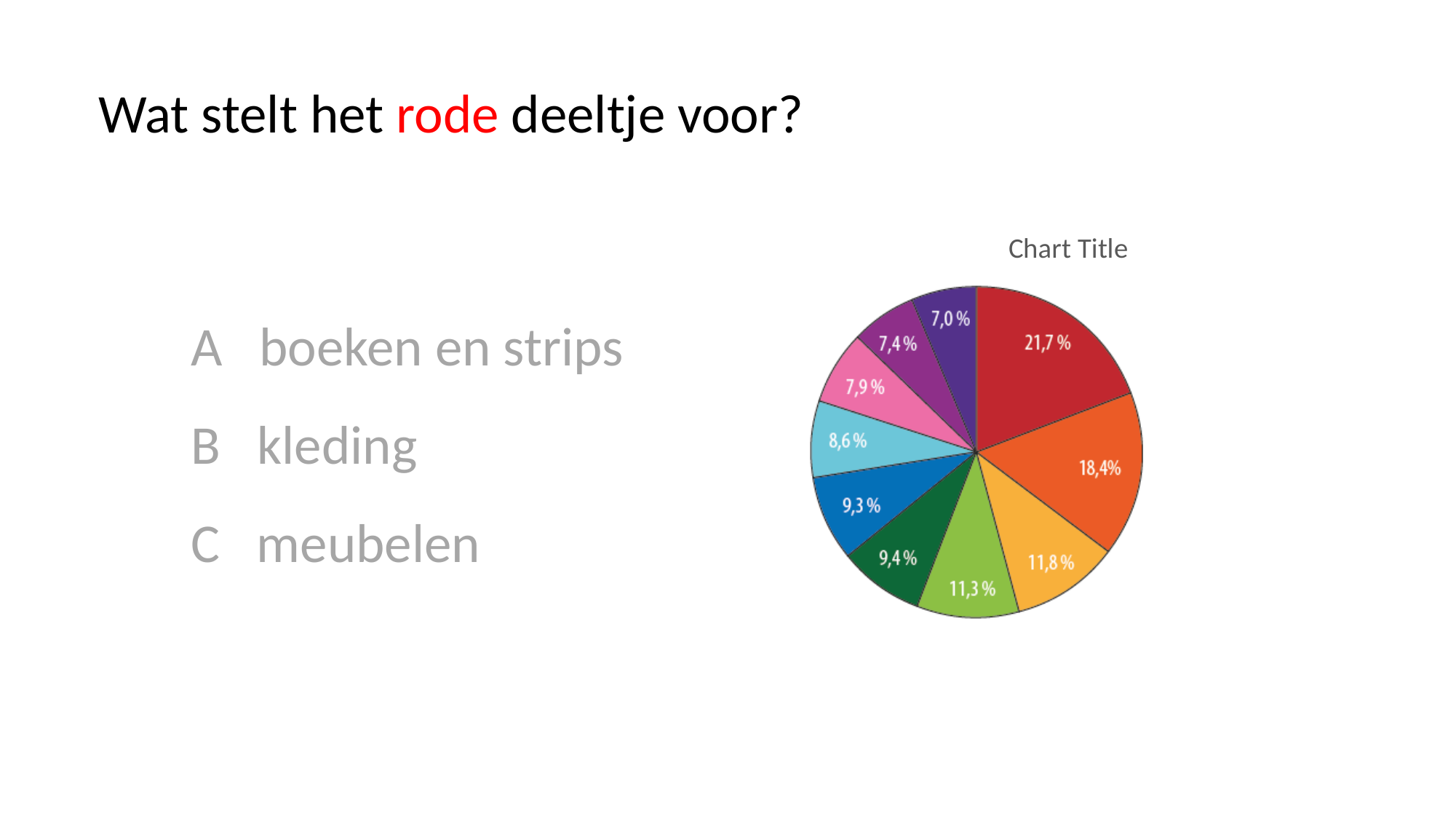
How many slices does the pie chart have? 10 Which slice of the pie chart has the largest share? the red slice (21,7 %) What is the difference between the red slice and the orange slice of the pie chart? 3,3 % What percentage is shown on the pink slice of the pie chart? 7,9 % What percentage is shown on the red slice of the pie chart? 21,7 % What is the title of the chart? Chart Title What is the difference between the light blue slice and the dark purple slice of the pie chart? 1,6 % What percentage is shown on the dark blue slice of the pie chart? 9,3 % Which is larger in the pie chart, the yellow slice or the light green slice? the yellow slice (11,8 %) What percentage is shown on the orange slice of the pie chart? 18,4% Which slice of the pie chart has the smallest share? the dark purple slice (7,0 %) What kind of chart is shown on the slide? pie chart